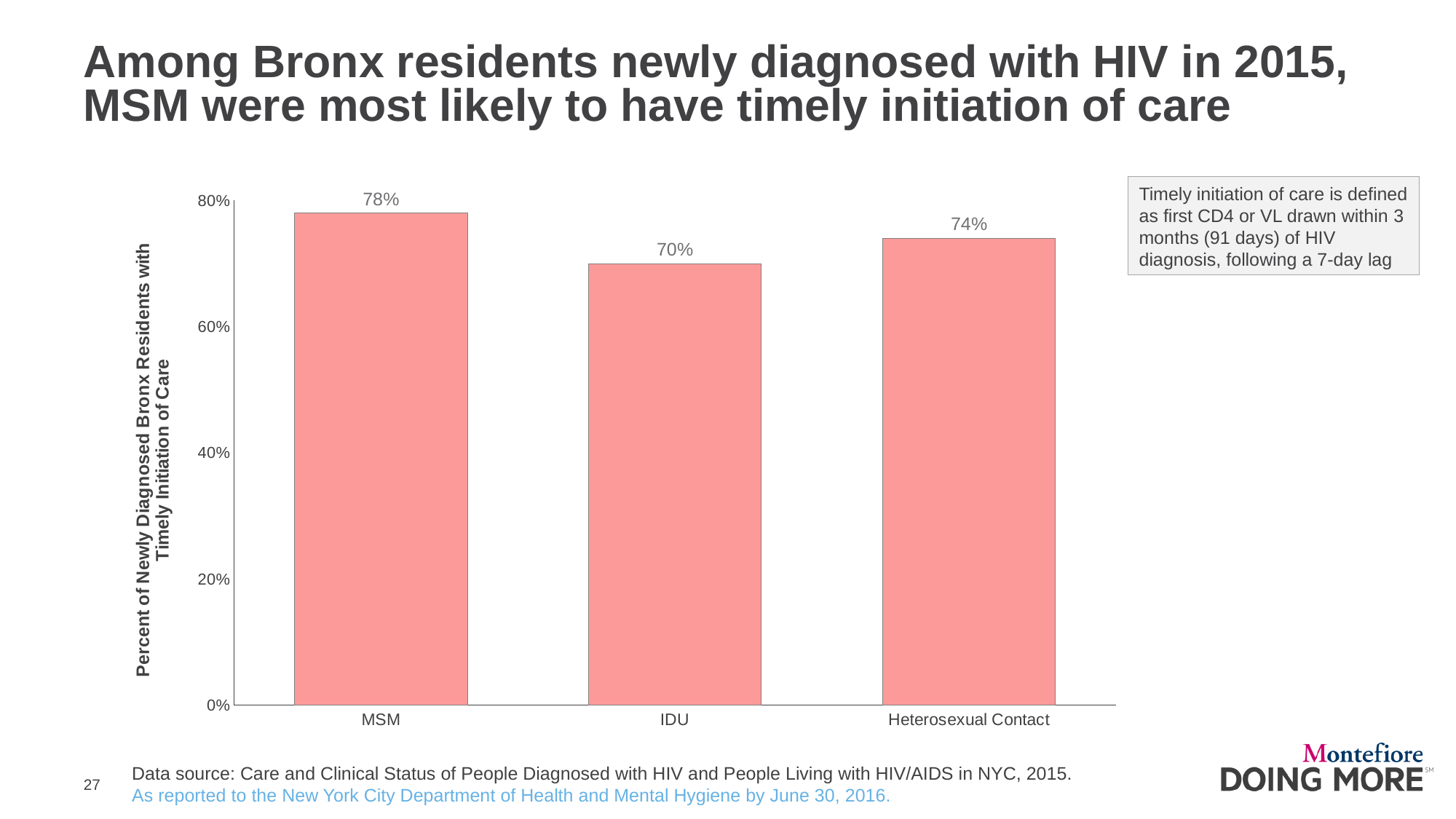
What kind of chart is shown on the slide? bar chart What is the value for IDU? 70% What is the value for Heterosexual Contact? 74% How many categories are shown on the x axis? 3 Which is larger, the value for Heterosexual Contact or the value for IDU? Heterosexual Contact Which category has the highest value? MSM Is the value for IDU greater or less than 60%? greater What is the label of the y axis? Percent of Newly Diagnosed Bronx Residents with Timely Initiation of Care What is the difference between the values for Heterosexual Contact and IDU? 4% What is the difference between the values for MSM and IDU? 8% What is the value for MSM? 78% Which category has the lowest value? IDU